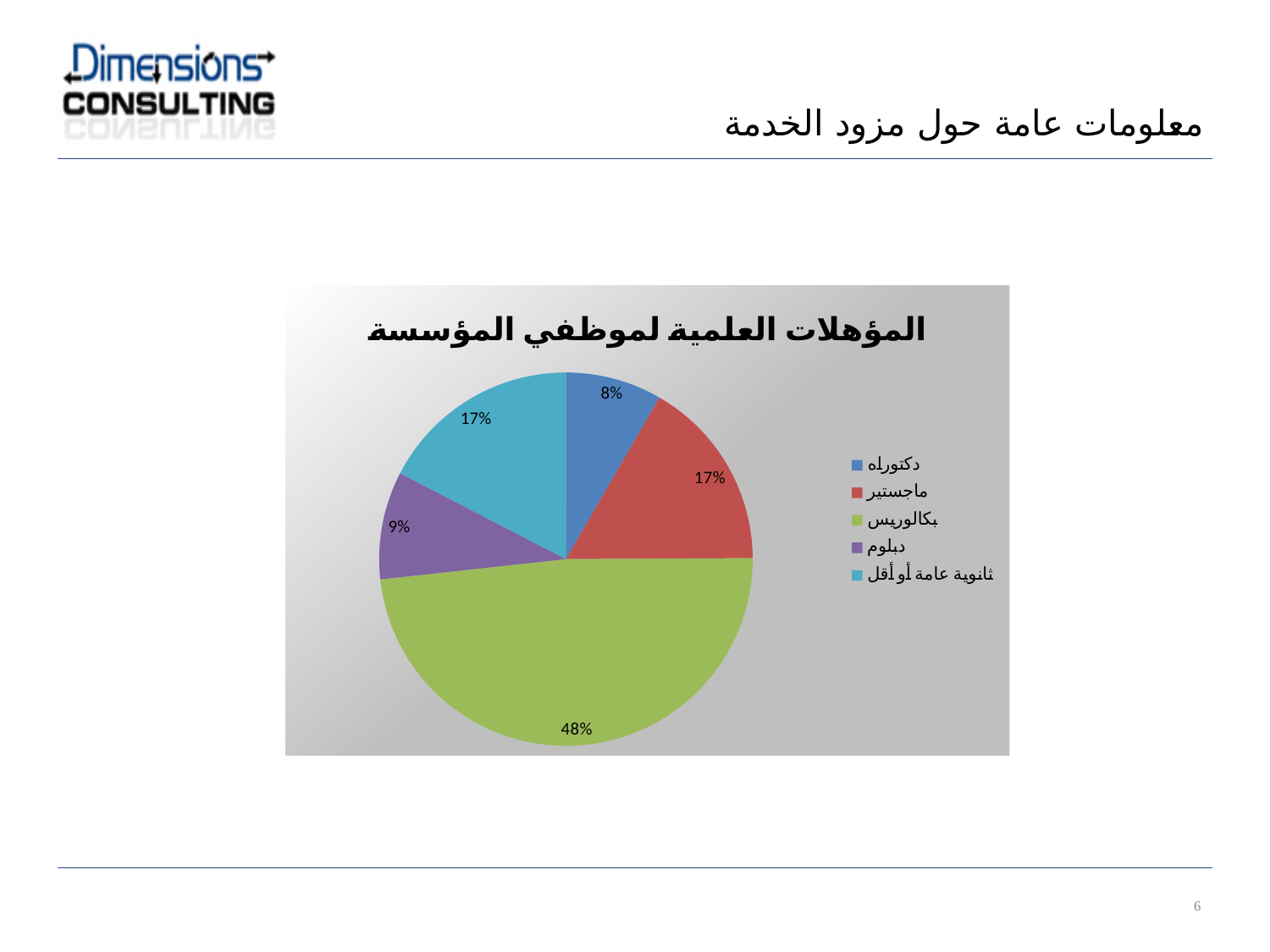
Which category has the largest slice of the pie? بكالوريس What share of the pie does دبلوم hold? 9% What kind of chart is shown on the slide? pie chart What share of the pie does بكالوريوس hold? 48% What is the title of the chart? المؤهلات العلمية لموظفي المؤسسة What share of the pie does دكتوراه hold? 8% Which category has the smallest slice of the pie? دكتوراه What is the difference in percentage points between بكالوريوس and ماجستير? 31 Which is larger, the share for دبلوم or the share for دكتوراه? دبلوم How many categories does the legend of the pie chart list? 5